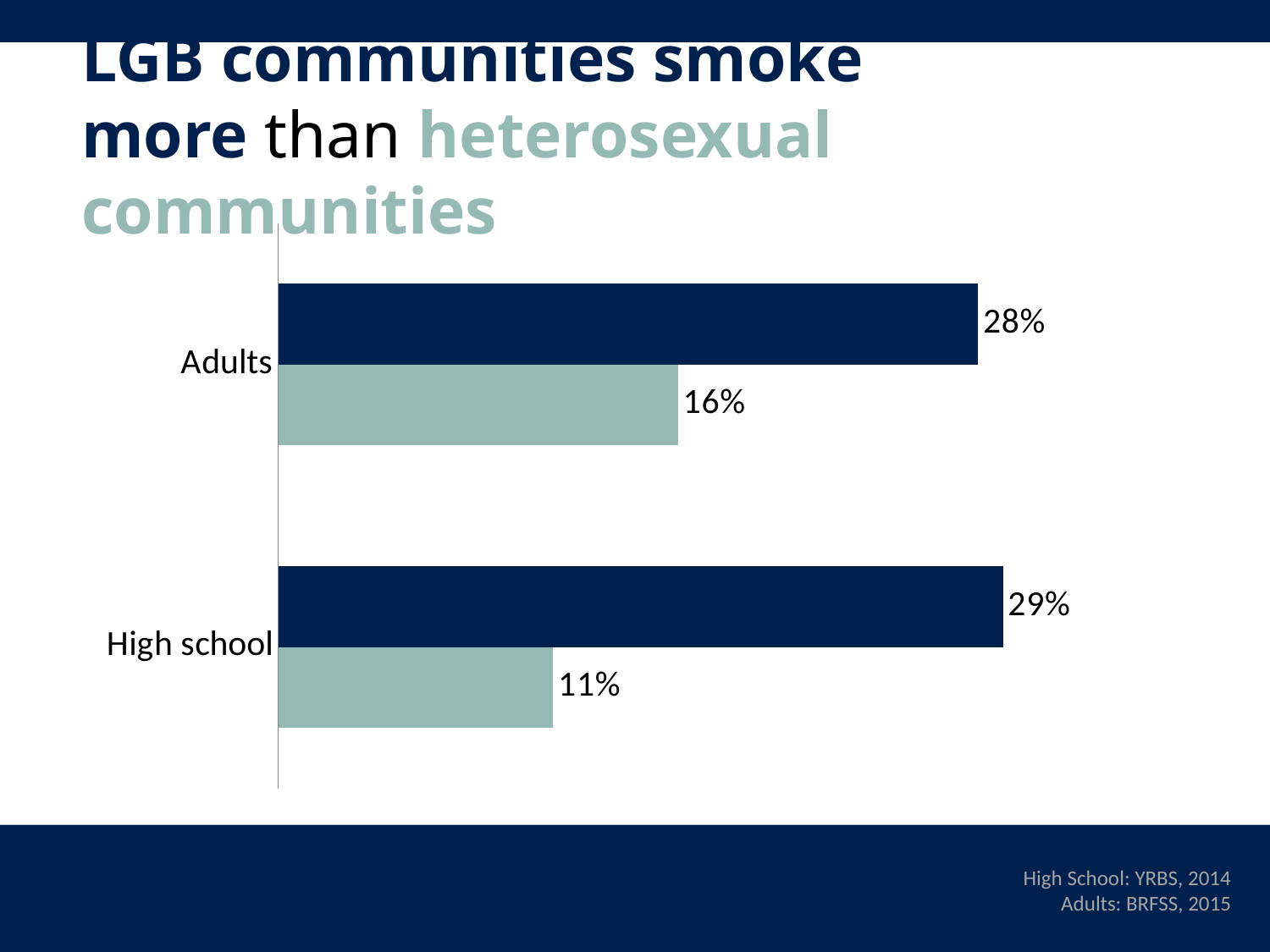
Which bar has the highest value on the chart? The dark navy bar for High school (29%) What is the difference between the dark navy and light teal bars for Adults? 12 percentage points How many categories are shown on the chart? 2 What is the value of the dark navy bar for High school? 29% What type of chart is shown on the slide? Bar chart What is the value of the light teal bar for Adults? 16% For the light teal bars, which category has the larger value, Adults or High school? Adults Which bar has the lowest value on the chart? The light teal bar for High school (11%) What is the difference between the dark navy and light teal bars for High school? 18 percentage points What is the value of the light teal bar for High school? 11% For High school, which bar is larger, the dark navy bar or the light teal bar? The dark navy bar What is the value of the dark navy bar for Adults? 28%